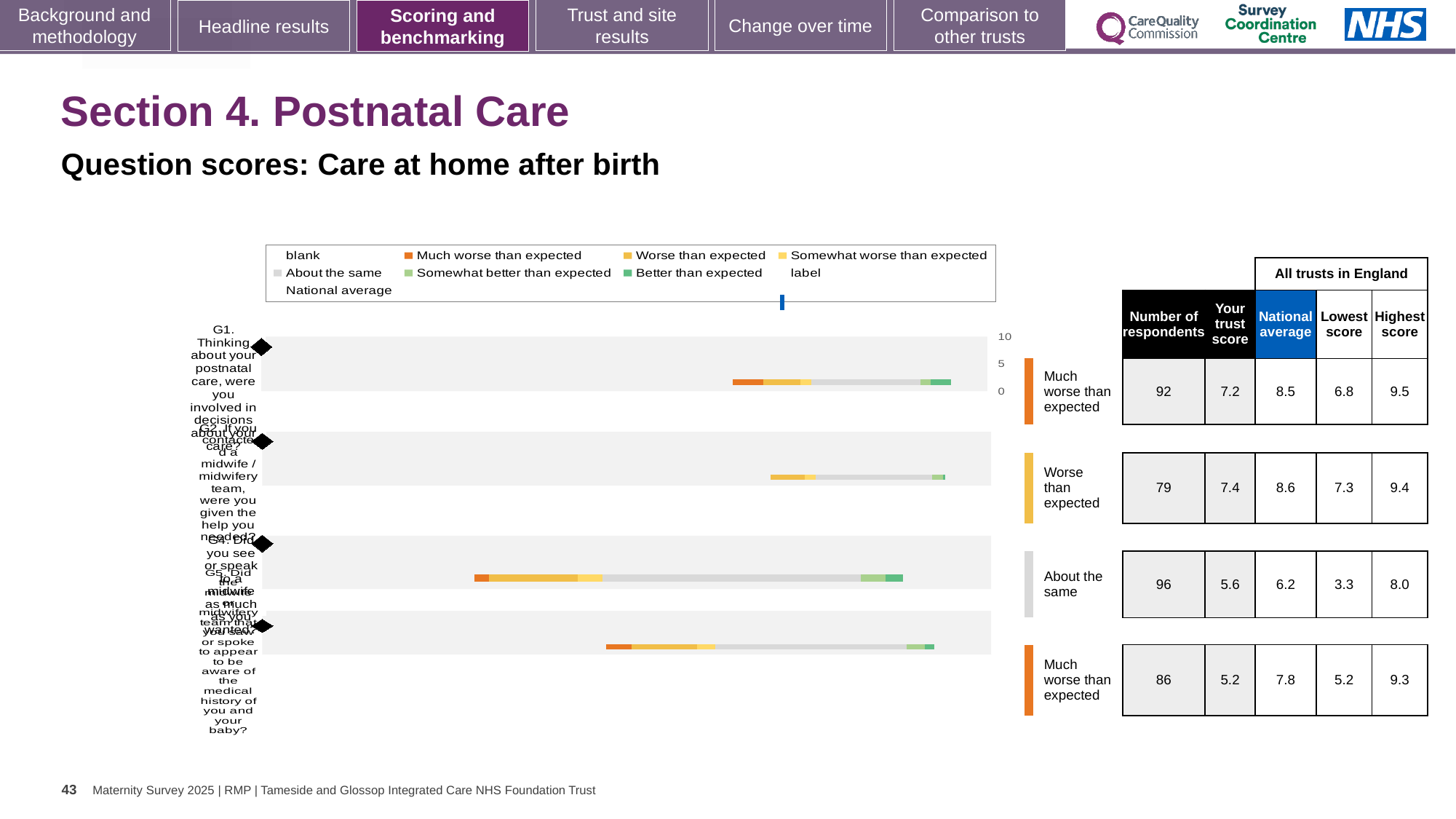
What is the difference between the national average and the trust score for the first row (G1)? 1.3 For the third row, which is larger: the trust score or the national average? the national average (6.2) What kind of chart is shown on the slide? bar chart How many question bars are plotted in the chart? 4 What benchmark rating is shown for the first row (G1)? Much worse than expected What is the highest score among all trusts in England for the third row (About the same)? 8.0 Which row has the highest trust score? the second row (G2), 7.4 What is the national average for the first row (G1)? 8.5 What benchmark rating is shown for the second row (G2)? Worse than expected What is the trust score for the first row (G1)? 7.2 What is the number of respondents for the first row (G1, involved in decisions about your care)? 92 Which row has the lowest trust score? the fourth row, 5.2